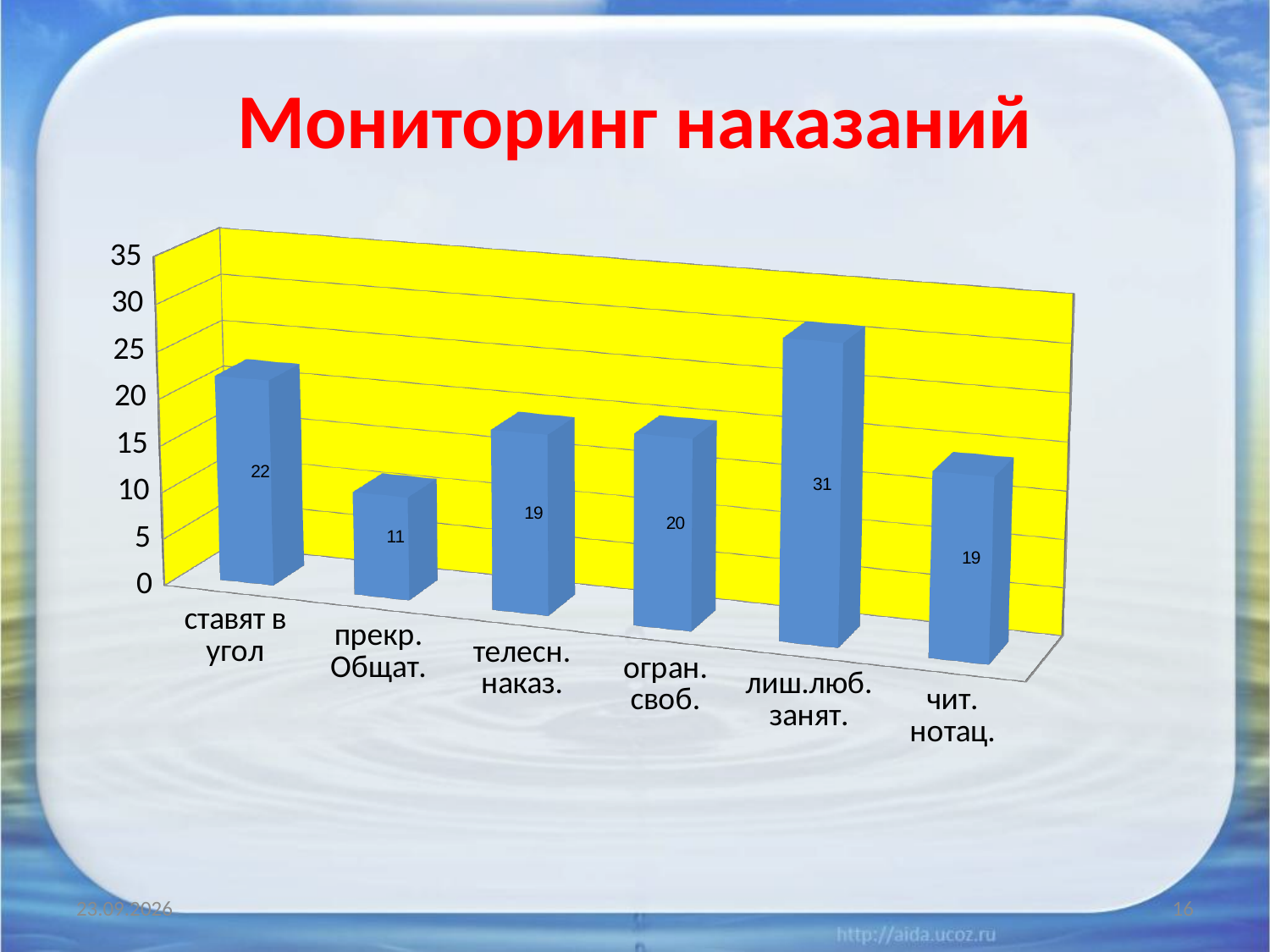
What is the value for "огран. своб."? 20 What is the title of the slide? Мониторинг наказаний Which is larger, the value for "ставят в угол" or the value for "огран. своб."? ставят в угол What is the difference between the values for "ставят в угол" and "телесн. наказ."? 3 What is the difference between the values for "лиш.люб. занят." and "прекр. Общат."? 20 What is the value for "ставят в угол"? 22 What is the value for "прекр. Общат."? 11 Which category has the highest value? лиш.люб. занят. How many categories are shown in the chart? 6 What kind of chart is shown on the slide? bar chart What is the value for "лиш.люб. занят."? 31 Which category has the lowest value? прекр. Общат.